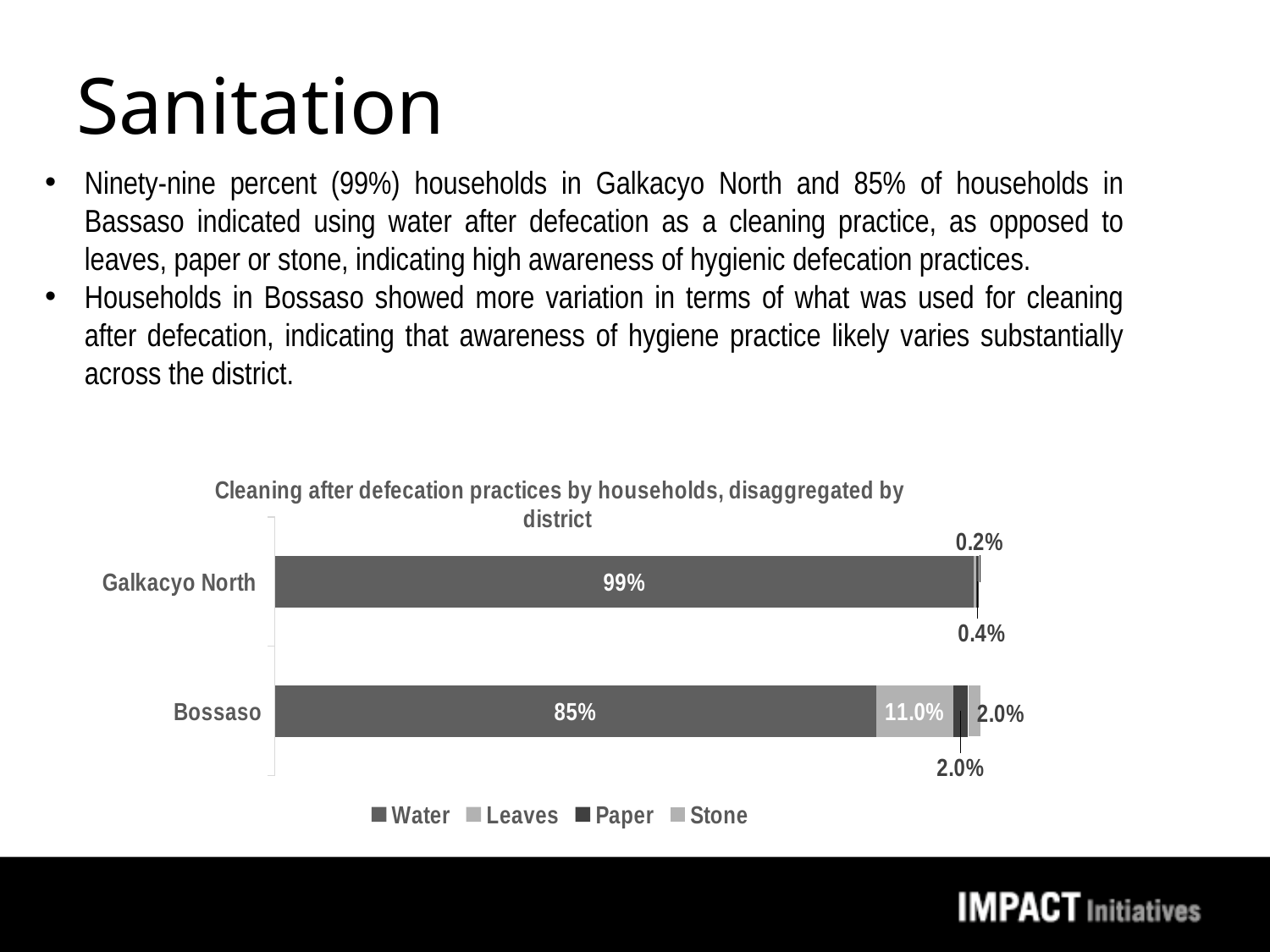
What kind of chart is shown on the slide? Stacked bar chart What is the difference in percentage points between the share of households using water in Galkacyo North and in Bossaso? 14 percentage points What percentage of households in Bossaso use water for cleaning after defecation? 85% What is the total of the stacked bar for Bossaso? 100% What is the title of the chart? Cleaning after defecation practices by households, disaggregated by district How many series does the chart legend list? 4 Which series are listed in the chart legend? Water, Leaves, Paper, Stone What percentage of households in Bossaso use leaves for cleaning after defecation? 11.0% What percentage of households in Galkacyo North use water for cleaning after defecation? 99% Which district has the higher share of households using water for cleaning after defecation? Galkacyo North What percentage of households in Bossaso use stone for cleaning after defecation? 2.0% How many districts are shown in the chart? 2